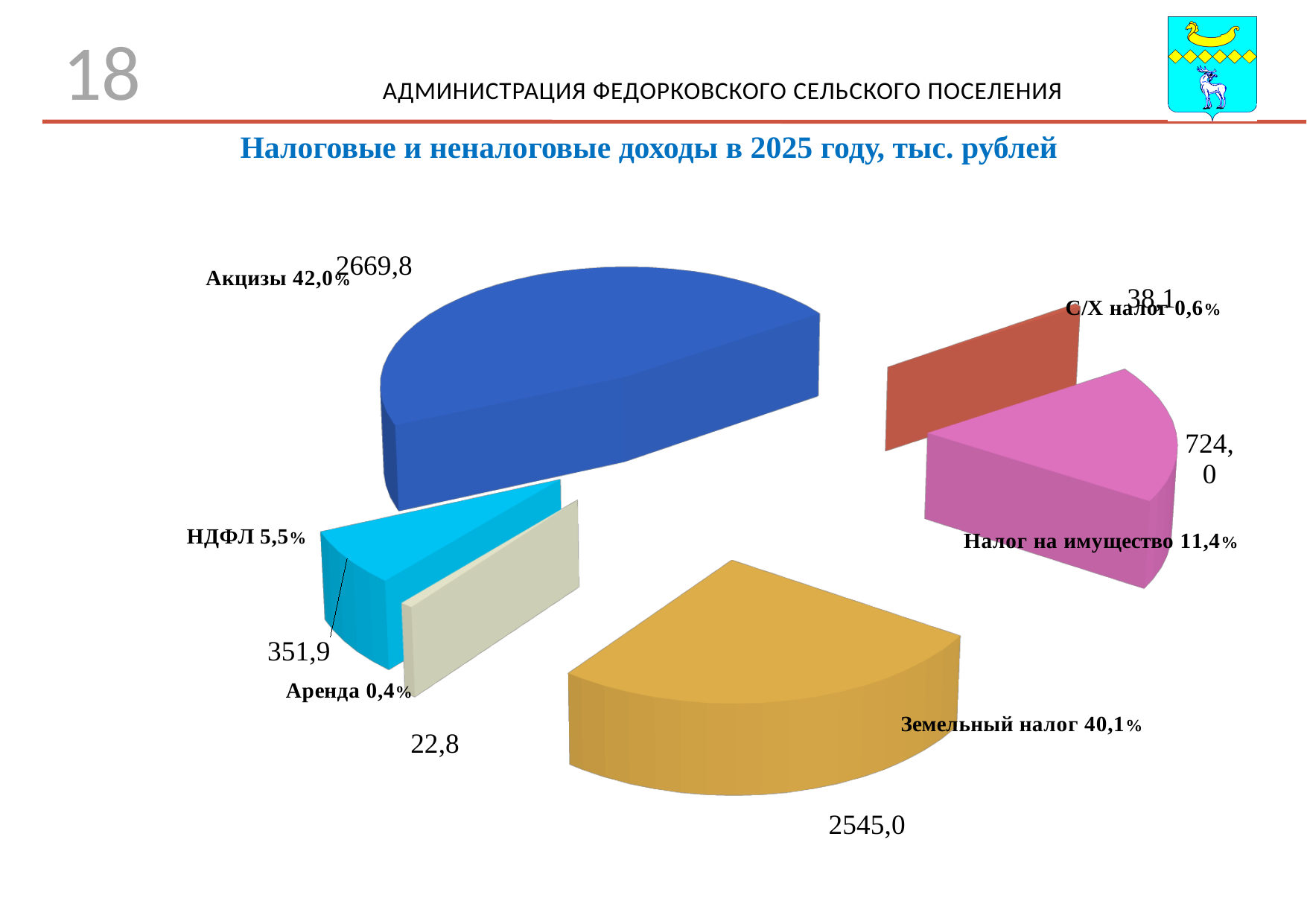
What is the value for НДФЛ? 351,9 Which category has the smallest share of the pie? Аренда What is the value for Акцизы? 2669,8 What is the value for С/Х налог? 38,1 What is the difference between the values for Акцизы and Земельный налог? 124,8 What is the value for Земельный налог? 2545,0 What is the value for Налог на имущество? 724,0 Which category has the largest share of the pie? Акцизы Which is larger, the value for Налог на имущество or the value for НДФЛ? Налог на имущество What share of the pie does Земельный налог represent? 40,1% What kind of chart is shown on the slide? pie chart How many slices does the pie chart have? 6